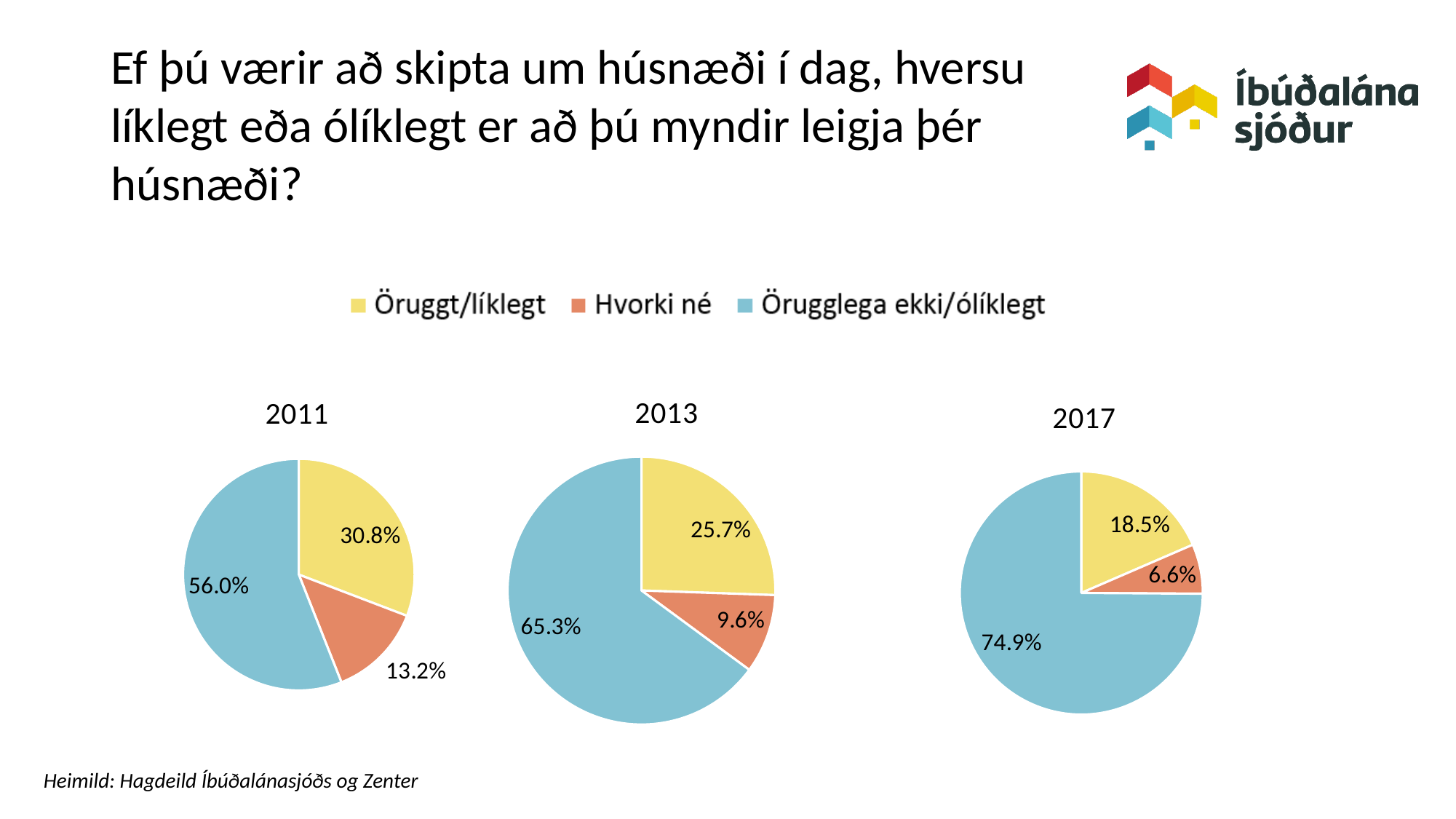
What kind of chart is used for the 2017 data? Pie chart In the 2017 pie chart, what share is labelled for Örugglega ekki/ólíklegt? 74.9% Is the Öruggt/líklegt share larger in the 2011 pie chart or the 2013 pie chart? 2011 In the 2017 pie chart, which category has the smallest slice? Hvorki né Which colour represents Hvorki né in the pie charts? Orange What is the difference between the Örugglega ekki/ólíklegt share in 2017 and in 2011? 18.9% How many slices does the 2013 pie chart have? 3 Across the 2011, 2013 and 2017 pie charts, does the Öruggt/líklegt share rise or fall over time? Fall In the 2011 pie chart, what share is labelled for Öruggt/líklegt? 30.8% How many categories does the legend list? 3 In the 2013 pie chart, what share is labelled for Hvorki né? 9.6% In the 2011 pie chart, which category has the largest slice? Örugglega ekki/ólíklegt